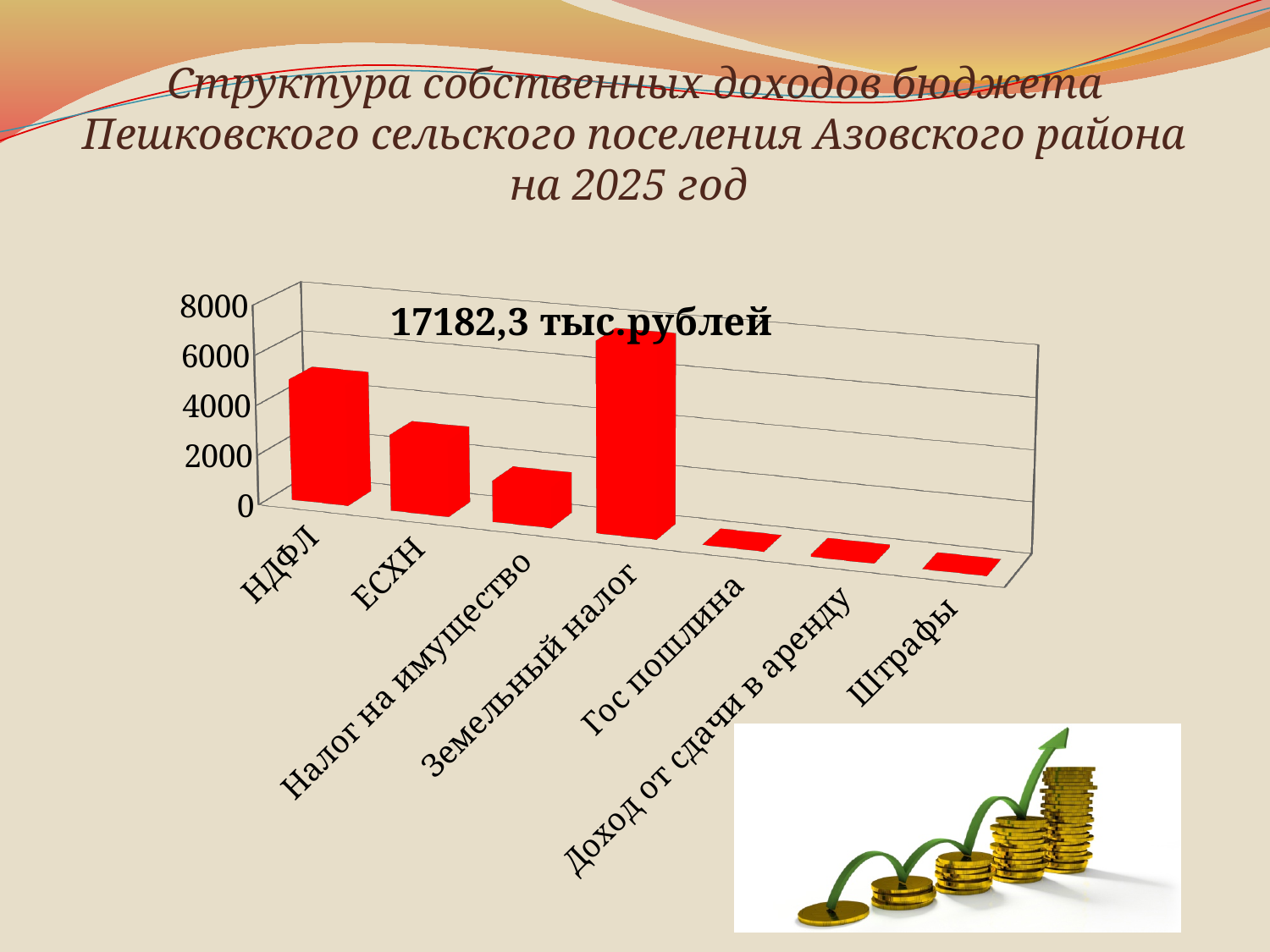
Is the value for Налог на имущество greater or less than 2000? less What total amount is printed as text inside the chart area? 17182,3 тыс.рублей Is the value for ЕСХН greater or less than 4000? less What colour are the bars in the chart? red Is the value for Гос пошлина greater or less than 2000? less Which category has the highest bar in the chart? Земельный налог Which is larger, the value for НДФЛ or the value for ЕСХН? НДФЛ Which is larger, the value for Земельный налог or the value for НДФЛ? Земельный налог How many categories are shown on the x axis of the chart? 7 What kind of chart is shown on the slide? bar chart